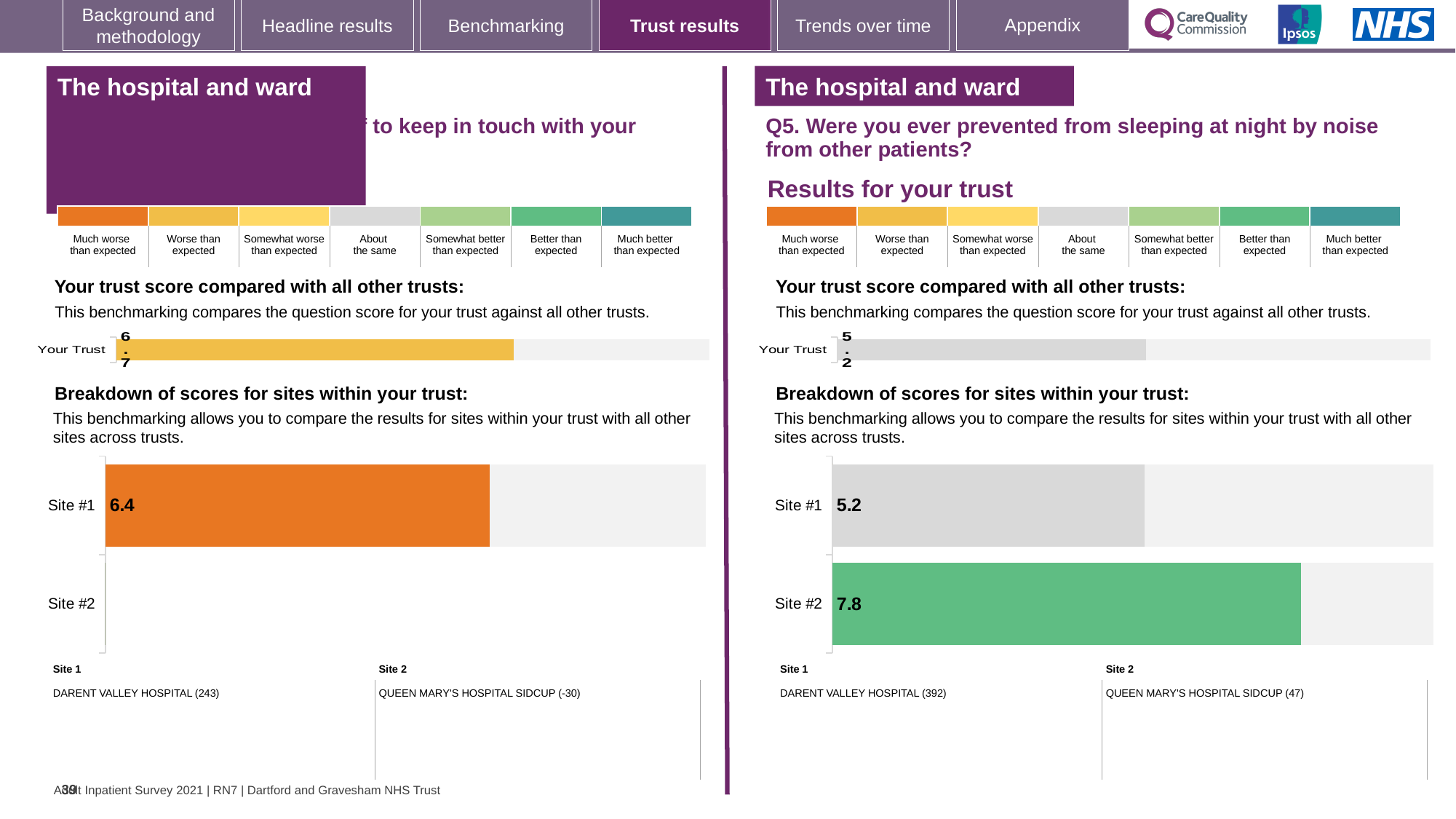
How many sites are listed in the site breakdown chart on the right-hand side for Q5? 2 On the left-hand chart, what colour is the Site #1 bar? Orange On the left-hand chart, what is the 'Your Trust' score shown in the trust comparison bar? 6.7 On the right-hand chart for Q5, what colour is the Site #2 bar? Green On the left-hand chart (breakdown of scores for sites within your trust), what is the score for Site #1? 6.4 What type of chart is used to show the breakdown of scores for sites within your trust on the right-hand side? Bar chart On the right-hand chart for Q5, what is the difference between the Site #2 score and the Site #1 score? 2.6 On the right-hand chart for Q5, what is the score for Site #2? 7.8 On the right-hand chart for Q5 (prevented from sleeping at night by noise from other patients), what is the score for Site #1? 5.2 On the right-hand chart for Q5, which site has the higher score, Site #1 or Site #2? Site #2 On the right-hand chart for Q5, which site has the lowest score? Site #1 On the right-hand chart for Q5, what is the 'Your Trust' score? 5.2